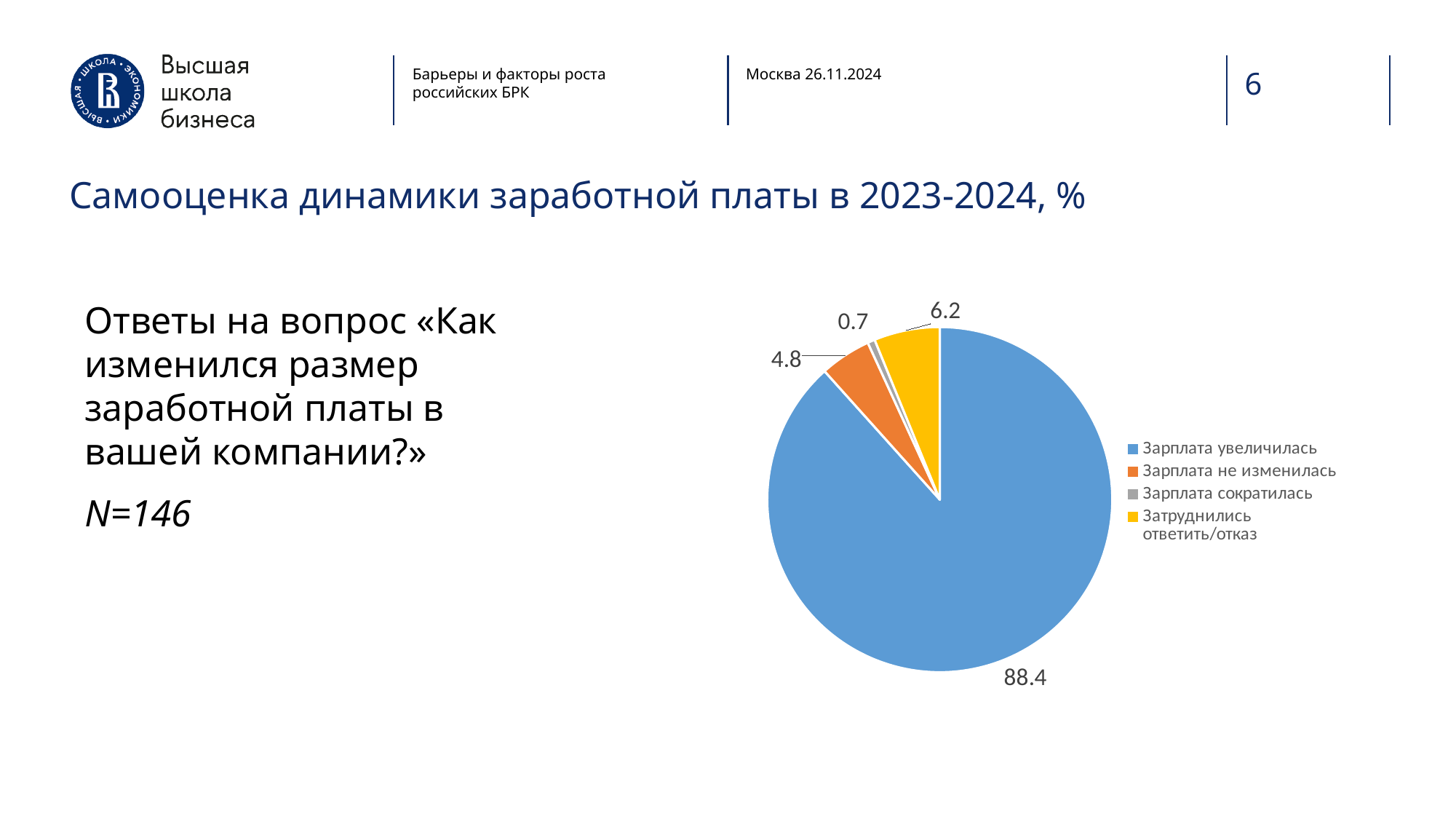
What type of chart is shown on the slide? Pie chart What is the title of the slide's chart section? Самооценка динамики заработной платы в 2023-2024, % What colour is the slice for «Затруднились ответить/отказ»? Yellow Which category has the largest share of the pie chart? Зарплата увеличилась Which category has the smallest share of the pie chart? Зарплата сократилась Which is larger: the value for «Зарплата не изменилась» or for «Затруднились ответить/отказ»? Затруднились ответить/отказ What is the value for «Зарплата сократилась» in the pie chart? 0.7 What is the value for «Зарплата не изменилась» in the pie chart? 4.8 What is the value for «Затруднились ответить/отказ» in the pie chart? 6.2 What is the value for «Зарплата увеличилась» in the pie chart? 88.4 What is the difference between the values for «Затруднились ответить/отказ» and «Зарплата не изменилась»? 1.4 How many slices does the pie chart have? 4